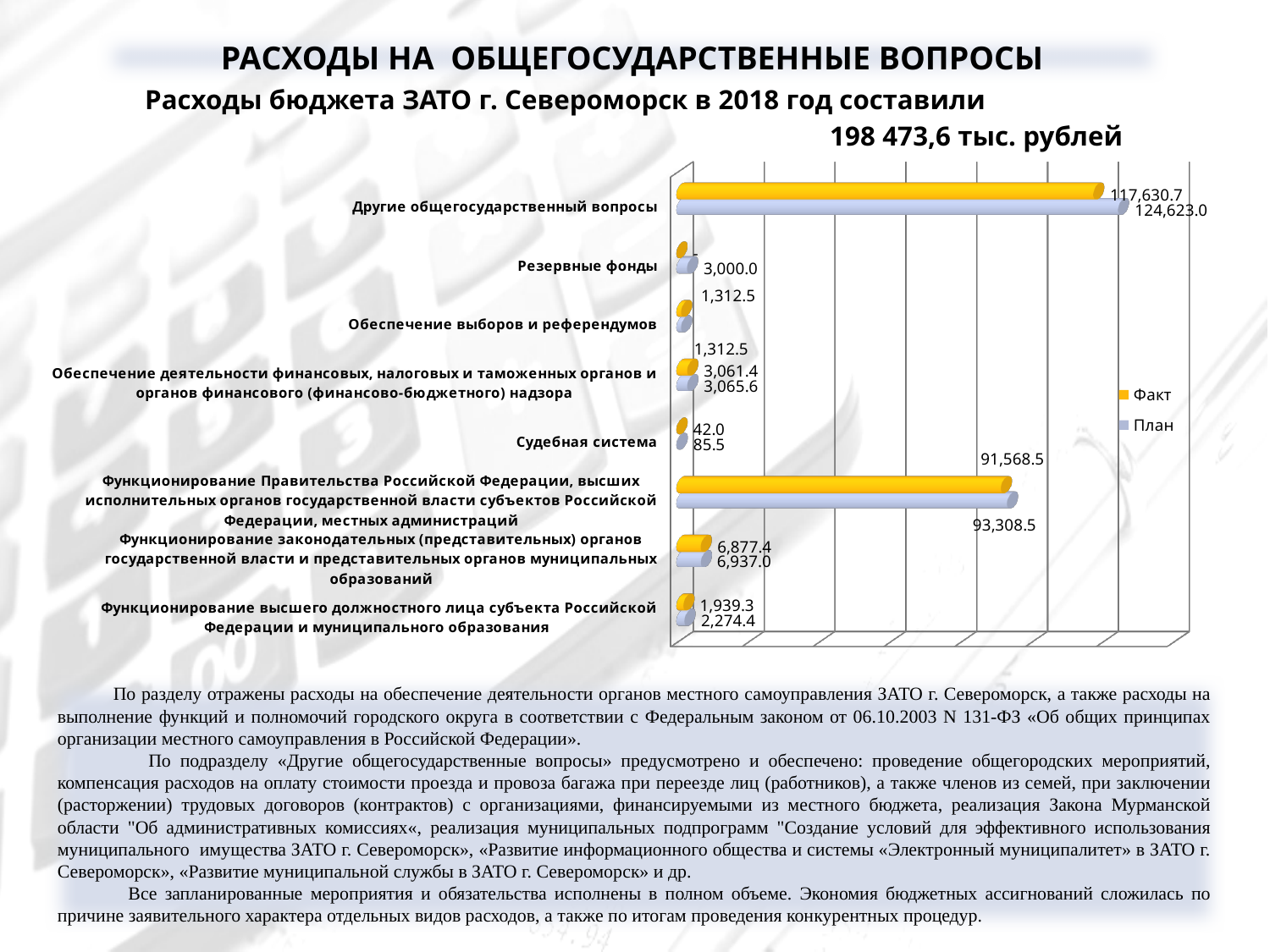
How many series does the legend list? 2 What is the План value for Функционирование Правительства Российской Федерации, высших исполнительных органов государственной власти субъектов Российской Федерации, местных администраций? 93,308.5 By how much does the План value exceed the Факт value for Другие общегосударственный вопросы? 6,992.3 What is the План value for Другие общегосударственный вопросы? 124,623.0 What is the difference between the План and Факт values for Судебная система? 43.5 What kind of chart is shown on the slide? Bar chart For Функционирование Правительства Российской Федерации, высших исполнительных органов государственной власти субъектов Российской Федерации, местных администраций, which is larger: Факт or План? План How many categories are shown on the chart? 8 Which category has the lowest План value? Судебная система What is the Факт value for Другие общегосударственный вопросы? 117,630.7 Which category has the highest Факт value? Другие общегосударственный вопросы What is the Факт value for Судебная система? 42.0